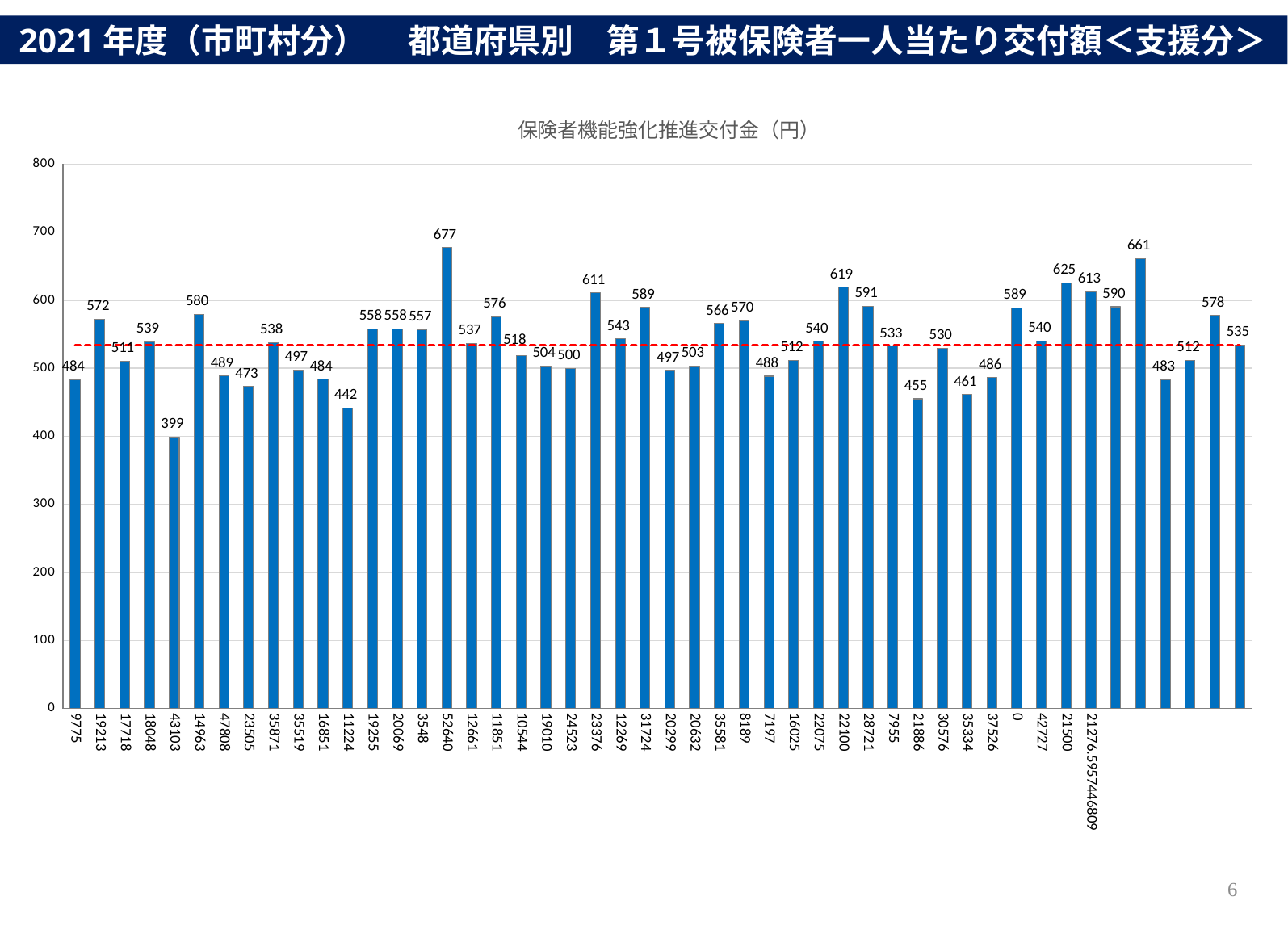
What is the difference between the highest value (677) and the lowest value (399)? 278 What is the value of the bar labelled 52640 on the x axis? 677 What is the title of the chart? 保険者機能強化推進交付金（円） What colour is the dashed horizontal reference line drawn across the chart? red What is the highest value shown in the chart? 677 What is the value of the bar labelled 43103 on the x axis? 399 What kind of chart is shown on the slide? bar chart What is the value of the first bar, labelled 9775? 484 What is the lowest value shown in the chart? 399 What is the value of the bar labelled 0 on the x axis? 589 Is the value for the bar labelled 14963 greater or less than 500? greater Which bar is larger, the one labelled 19213 or the one labelled 17718? 19213